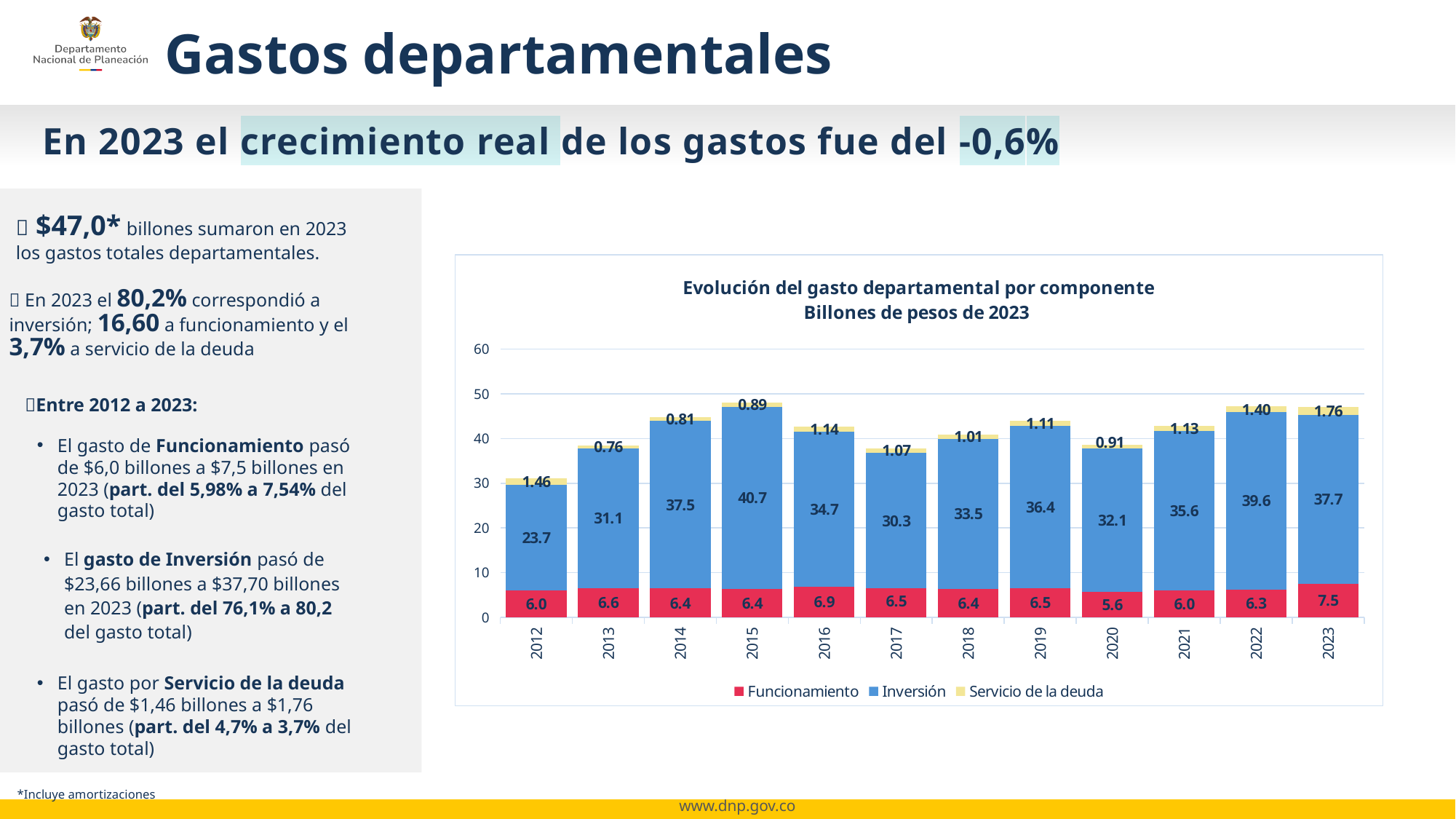
What type of chart is shown on the slide? stacked bar chart Which is larger, Servicio de la deuda in 2023 or Servicio de la deuda in 2022? 2023 What is the difference between Inversión in 2023 and Inversión in 2012? 14.0 In which year is Inversión highest? 2015 What is the value of Funcionamiento in 2023? 7.5 In which year is Funcionamiento lowest? 2020 How many series does the legend of the chart list? 3 How many years are shown on the x axis of the chart? 12 What is the total of the stacked bar for 2012? 31.16 What is the value of Servicio de la deuda in 2013? 0.76 What is the title of the chart? Evolución del gasto departamental por componente Billones de pesos de 2023 What is the value of Inversión in 2015? 40.7